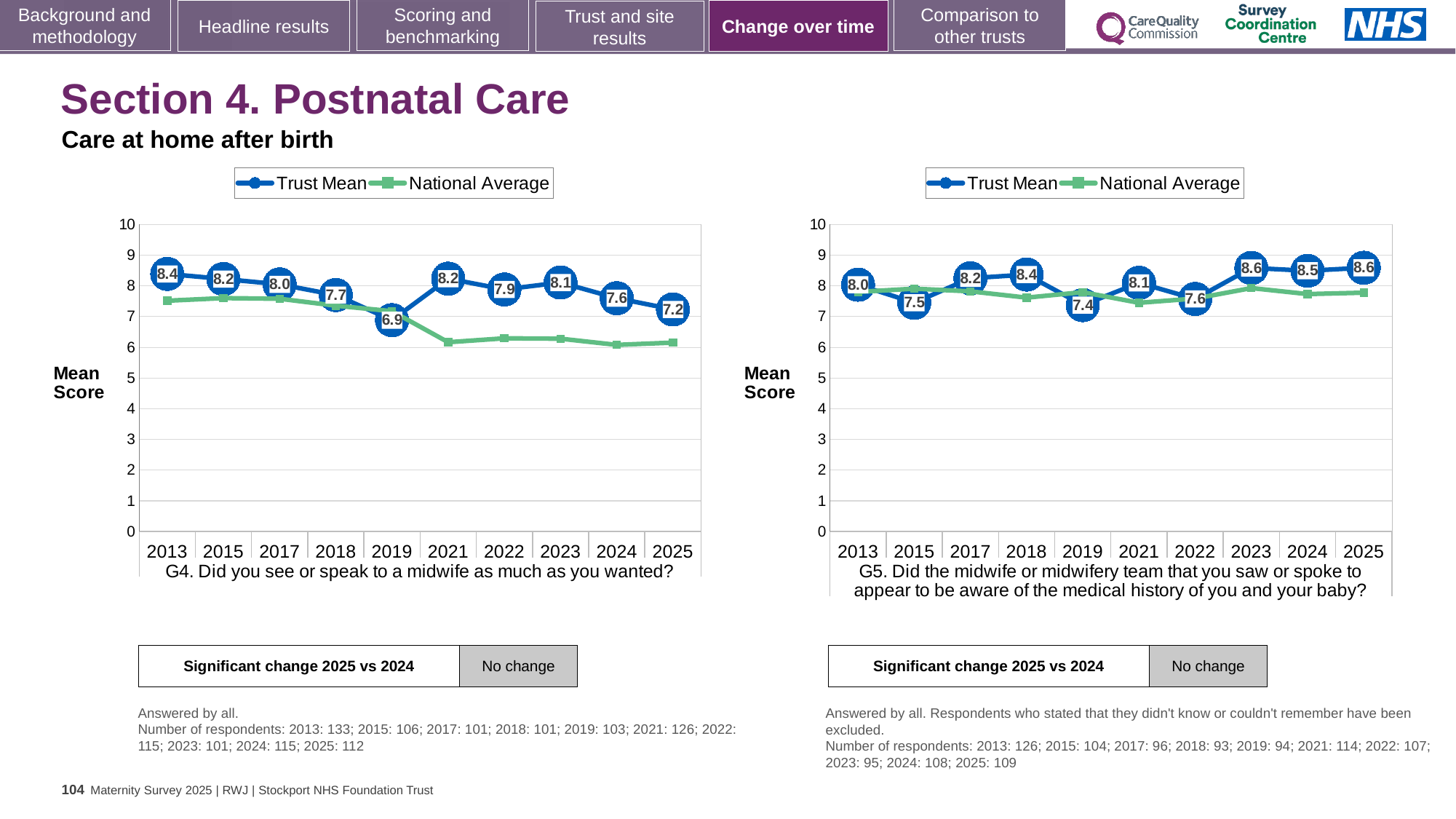
How many series does the legend of the G4 chart list? 2 In the G4 chart, which year has the highest Trust Mean? 2013 In the G4 chart, what is the Trust Mean for 2019? 6.9 In the G4 chart, what is the difference between the Trust Mean in 2013 and in 2025? 1.2 In the G5 chart, what is the Trust Mean for 2018? 8.4 In the G5 chart, which is larger, the Trust Mean for 2015 or for 2017? 2017 In the G4 chart, what is the Trust Mean for 2025? 7.2 How many years are plotted on the x axis of the G5 chart? 10 In the G4 chart, which year has the lowest Trust Mean? 2019 In the G4 chart, is the National Average for 2025 greater or less than 7? less In the G5 chart, which year has the lowest Trust Mean? 2019 In the G5 chart, is the National Average for 2025 greater or less than 7? greater